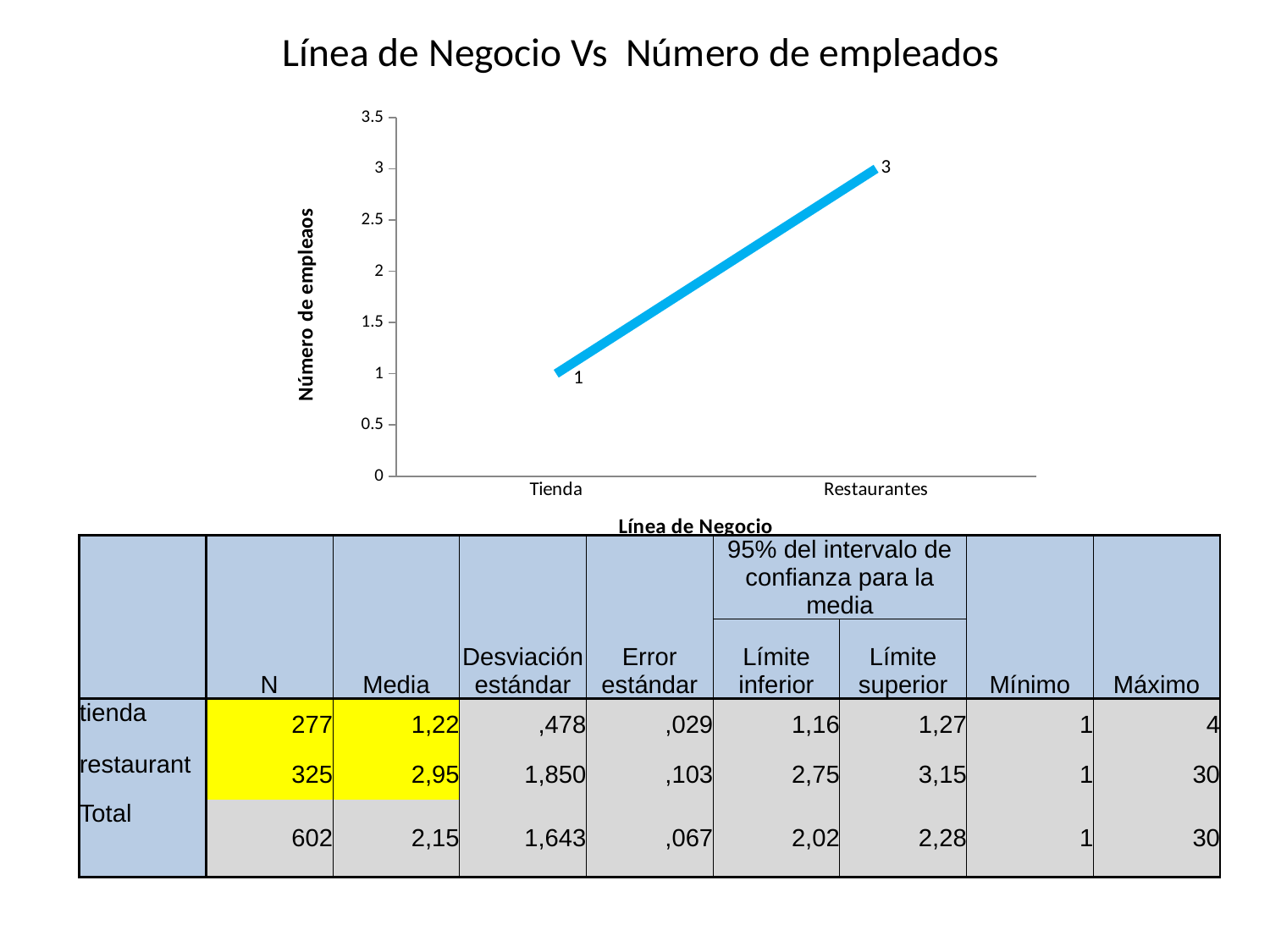
What is the value for Restaurantes in the chart? 3 Is the value for Restaurantes in the chart greater or less than 2? greater What is the value for Tienda in the chart? 1 Which is larger in the chart, the value for Tienda or the value for Restaurantes? Restaurantes What kind of chart is shown on the slide? line chart How many categories are shown on the x axis of the chart? 2 What is the label of the vertical axis of the chart? Número de empleaos Do the values in the chart rise or fall from Tienda to Restaurantes? rise Which category has the lowest value in the chart? Tienda Which category has the highest value in the chart? Restaurantes What is the difference between the values for Restaurantes and Tienda in the chart? 2 Is the value for Tienda in the chart greater or less than 2? less